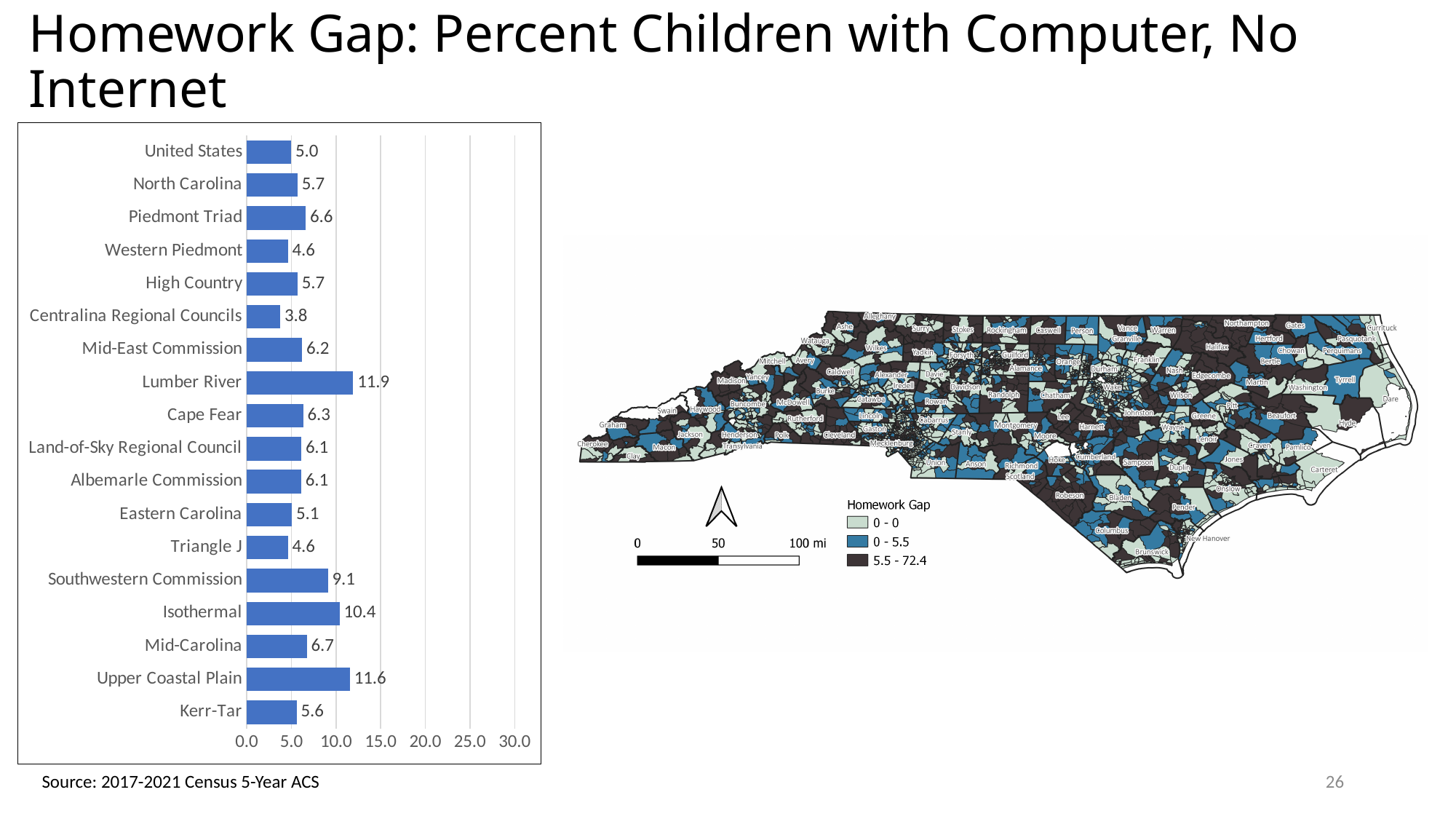
What is the value for Centralina Regional Councils in the bar chart? 3.8 What kind of chart is shown on the left of the slide? bar chart Which is larger in the bar chart, Isothermal or Southwestern Commission? Isothermal What is the value for Lumber River in the bar chart? 11.9 Which category has the highest value in the bar chart? Lumber River What is the highest value shown on the x axis of the bar chart? 30.0 What is the value for North Carolina in the bar chart? 5.7 What is the difference between the values for Upper Coastal Plain and United States in the bar chart? 6.6 How many categories are shown in the bar chart? 18 Which category has the lowest value in the bar chart? Centralina Regional Councils Is the value for Mid-Carolina in the bar chart greater or less than 10.0? less How many categories does the map legend titled Homework Gap list? 3